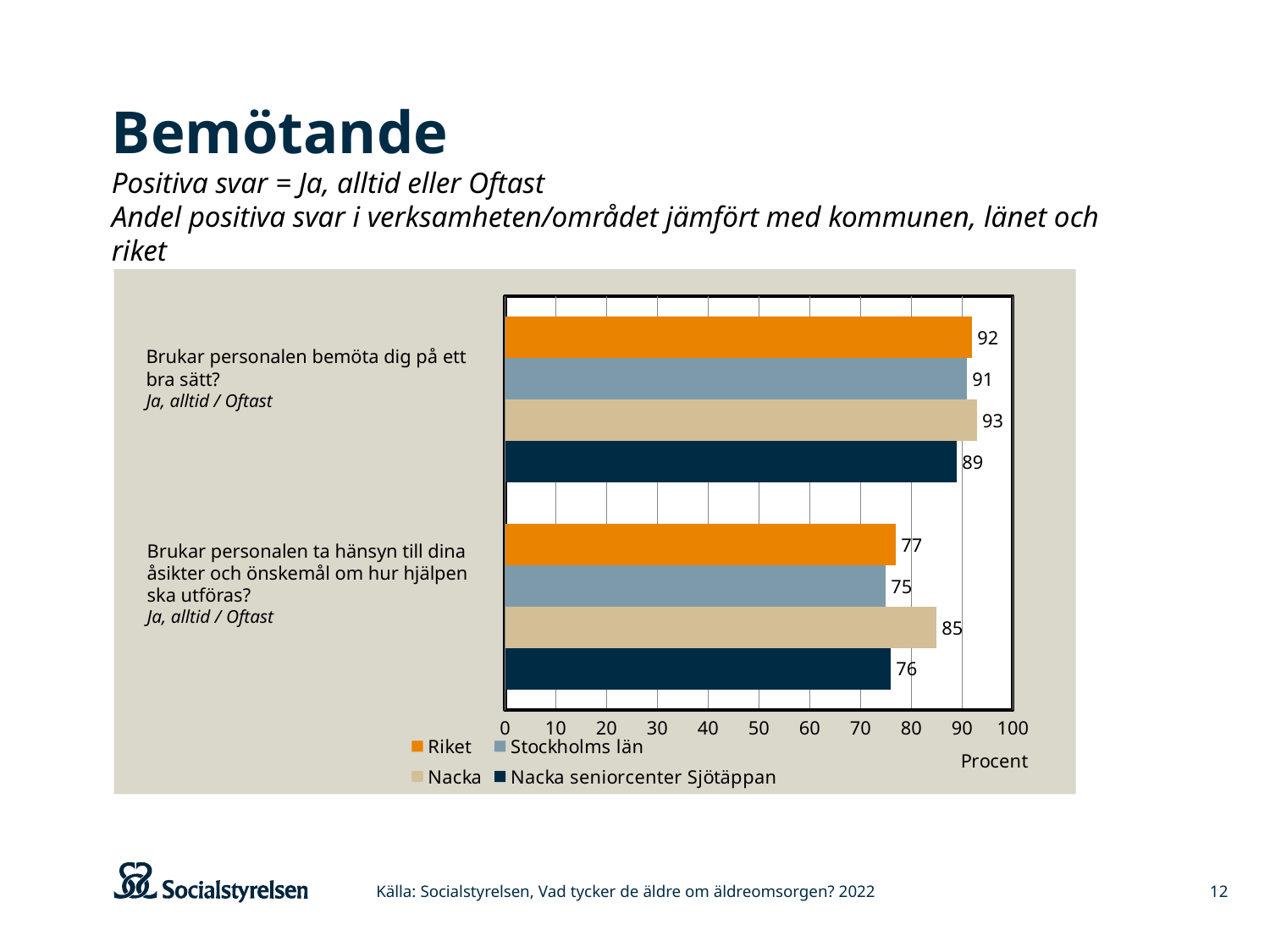
Which is larger on the question "Brukar personalen ta hänsyn till dina åsikter och önskemål om hur hjälpen ska utföras?": the value for Riket or the value for Nacka? Nacka What is the value for Riket on the question "Brukar personalen bemöta dig på ett bra sätt?"? 92 What is the difference between the Nacka value and the Nacka seniorcenter Sjötäppan value on the question "Brukar personalen bemöta dig på ett bra sätt?"? 4 Which series has the lowest value on the question "Brukar personalen bemöta dig på ett bra sätt?"? Nacka seniorcenter Sjötäppan How many series does the legend list? 4 What label is shown on the horizontal axis of the chart? Procent How many question categories are shown on the chart? 2 What kind of chart is shown on the slide? bar chart What is the difference between the Nacka value and the Stockholms län value on the question "Brukar personalen ta hänsyn till dina åsikter och önskemål om hur hjälpen ska utföras?"? 10 Which series has the highest value on the question "Brukar personalen ta hänsyn till dina åsikter och önskemål om hur hjälpen ska utföras?"? Nacka What is the value for Stockholms län on the question "Brukar personalen ta hänsyn till dina åsikter och önskemål om hur hjälpen ska utföras?"? 75 What is the value for Nacka seniorcenter Sjötäppan on the question "Brukar personalen ta hänsyn till dina åsikter och önskemål om hur hjälpen ska utföras?"? 76